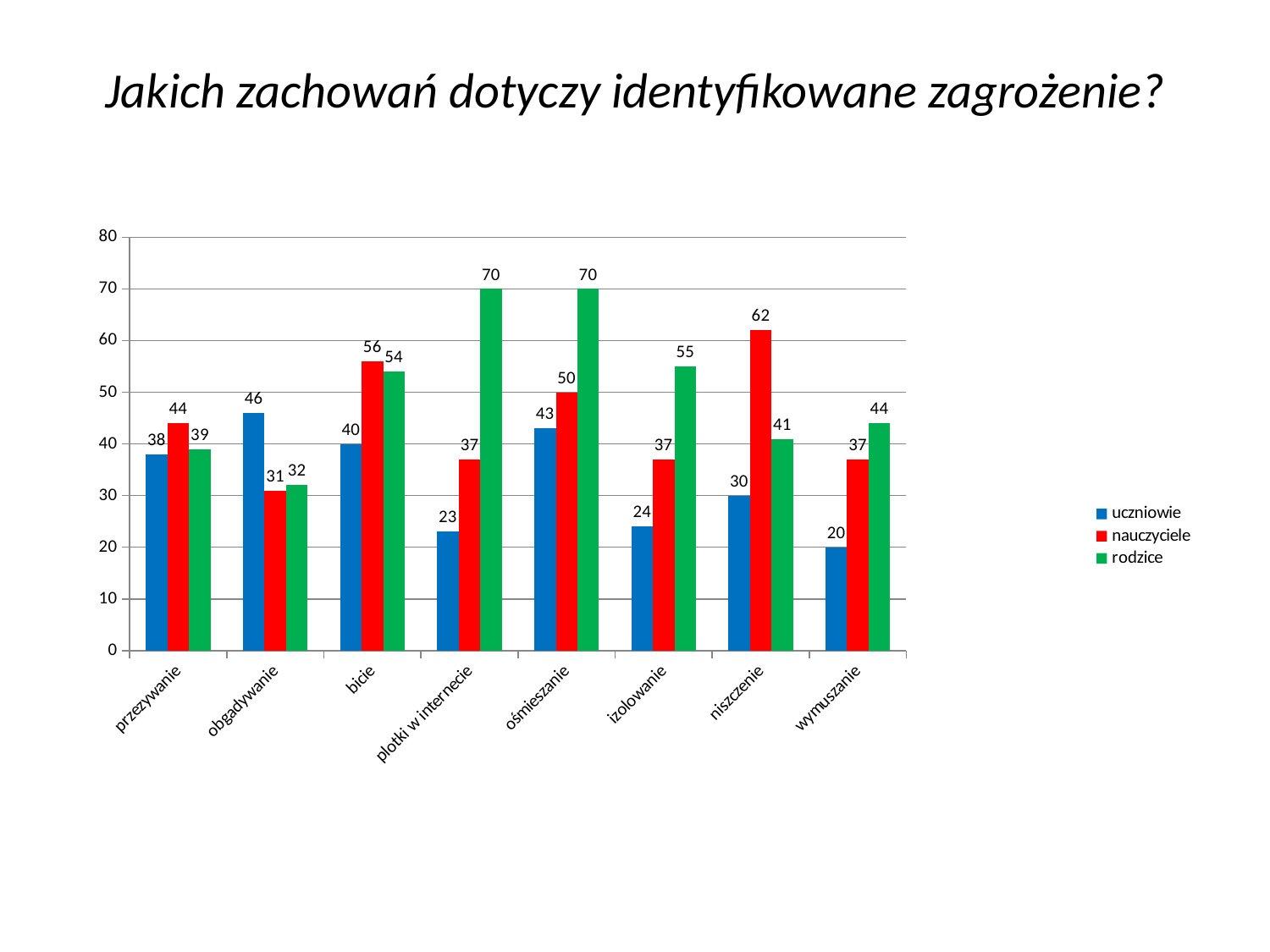
Which category has the highest value for uczniowie? obgadywanie Which colour represents the rodzice series? green How many series does the legend list? 3 What is the value for nauczyciele in the niszczenie category? 62 Which category has the lowest value for uczniowie? wymuszanie What is the value for rodzice in the izolowanie category? 55 Which is larger in the przezywanie category: the value for nauczyciele or the value for rodzice? nauczyciele Which category has the lowest value for nauczyciele? obgadywanie How many categories are shown on the x axis? 8 What is the difference between the rodzice and uczniowie values in the plotki w internecie category? 47 What is the value for uczniowie in the bicie category? 40 What kind of chart is shown on the slide? bar chart